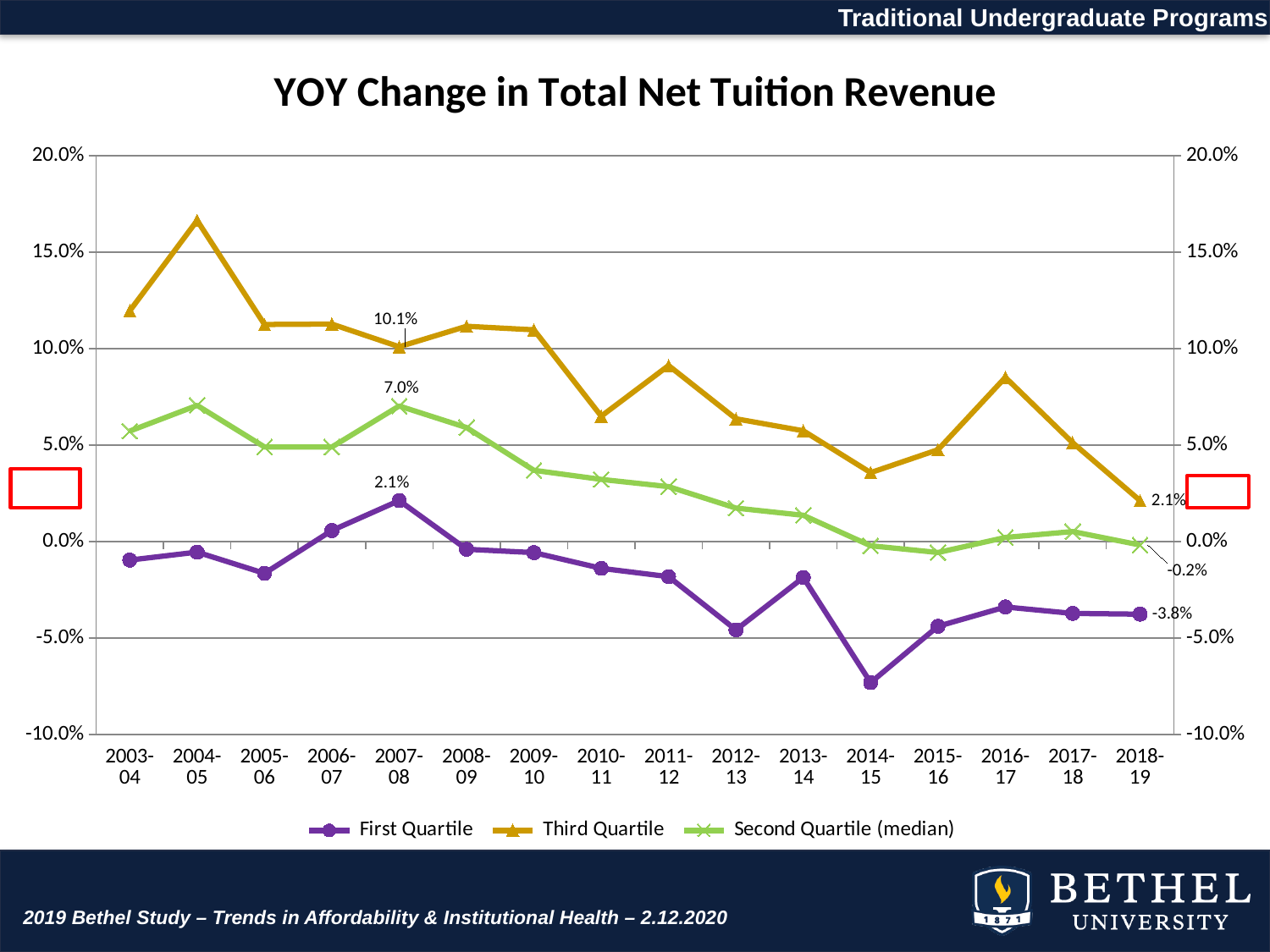
Is the Third Quartile value for 2004-05 greater or less than 15.0%? greater What is the Third Quartile value for 2007-08? 10.1% What is the Second Quartile (median) value for 2007-08? 7.0% What is the difference between the Third Quartile and First Quartile values in 2007-08? 8.0 percentage points In which year is the First Quartile value lowest? 2014-15 How many academic years are shown on the x axis? 16 What kind of chart is shown on the slide? line chart In which year is the Third Quartile value highest? 2004-05 By how much did the Third Quartile value fall from 2007-08 to 2018-19? 8.0 percentage points How many series does the legend list? 3 What is the First Quartile value for 2018-19? -3.8% What is the Second Quartile (median) value for 2018-19? -0.2%